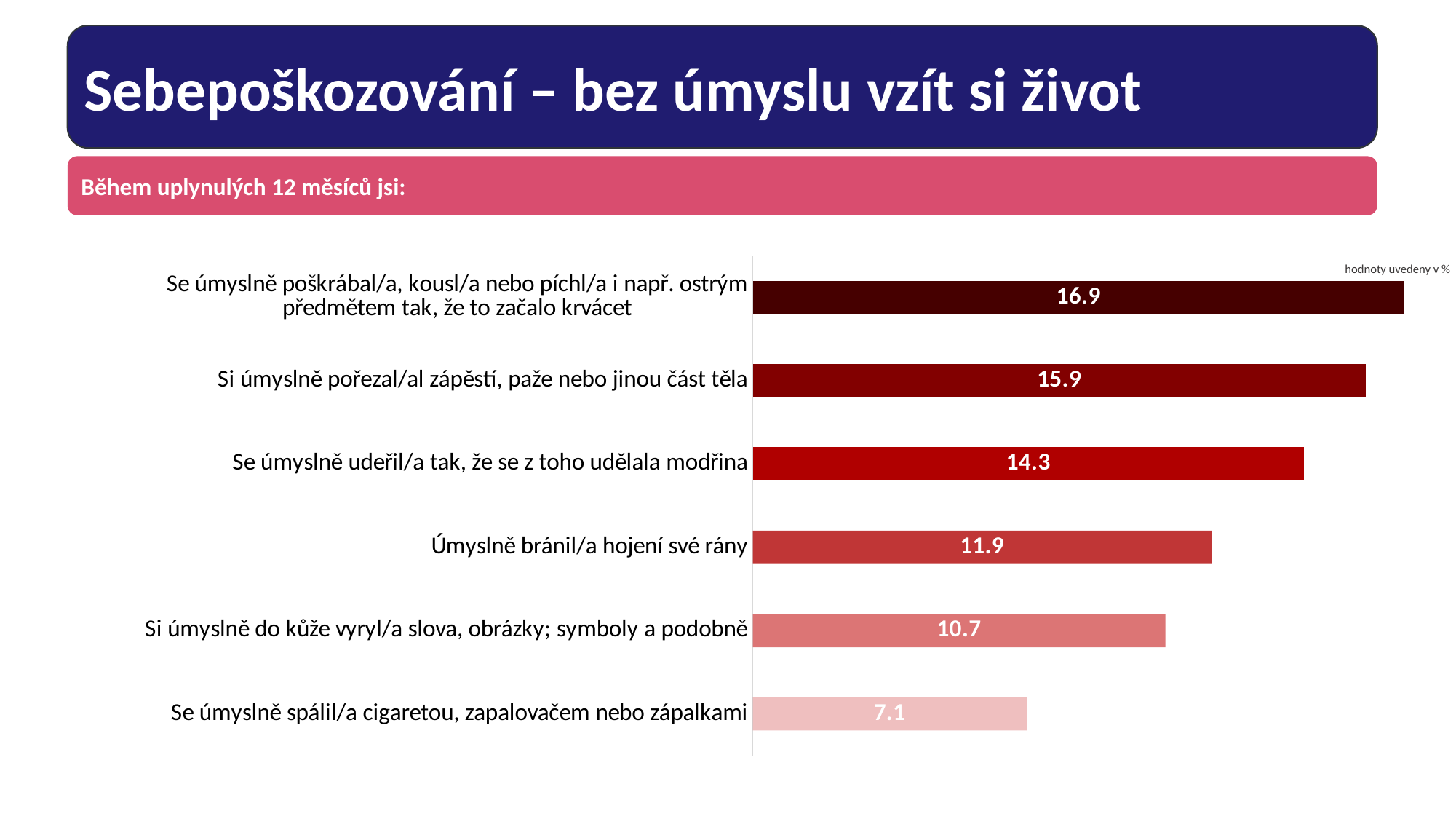
What is the difference between the values for "Se úmyslně uděřil/a tak, že se z toho udělala modřina" and "Se úmyslně spálil/a cigaretou, zapalovačem nebo zápalkami"? 7.2 How many categories are shown in the chart? 6 What is the value for "Úmyslně bránil/a hojení své rány"? 11.9 Which category has the highest value? Se úmyslně poškrábal/a, kousl/a nebo píchl/a i např. ostrým předmětem tak, že to začalo krvácet In what unit are the values in the chart given, according to the note on the slide? % What is the value for "Si úmyslně do kůže vyryl/a slova, obrázky; symboly a podobně"? 10.7 What is the difference between the highest and lowest values in the chart? 9.8 What kind of chart is shown on the slide? Bar chart Which category has the lowest value? Se úmyslně spálil/a cigaretou, zapalovačem nebo zápalkami Which is larger: the value for "Úmyslně bránil/a hojení své rány" or the value for "Si úmyslně do kůže vyryl/a slova, obrázky; symboly a podobně"? Úmyslně bránil/a hojení své rány What is the value for "Se úmyslně spálil/a cigaretou, zapalovačem nebo zápalkami"? 7.1 What is the value for "Si úmyslně pořezal/al zápěstí, paže nebo jinou část těla"? 15.9